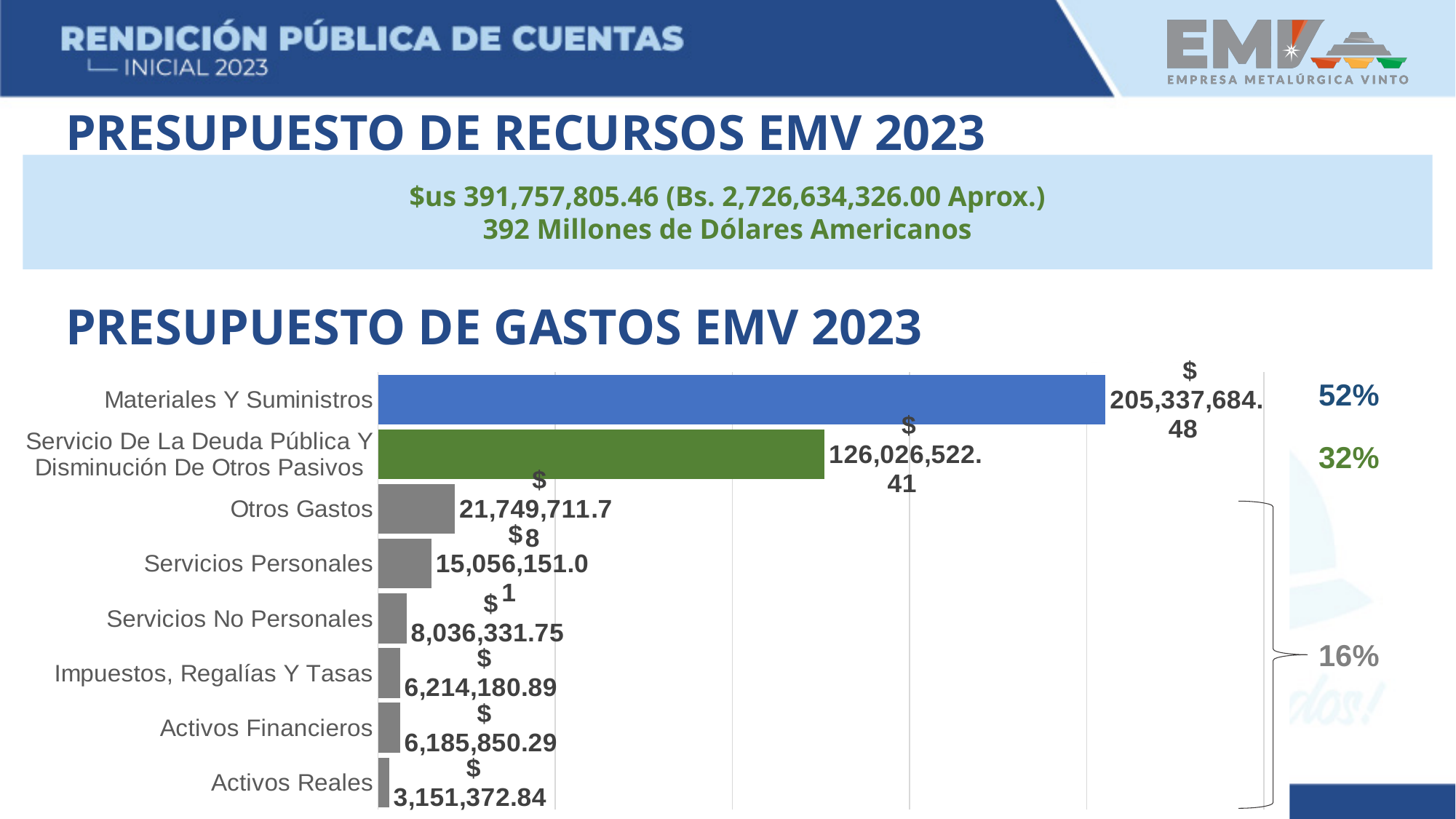
Which category has the lowest value in the PRESUPUESTO DE GASTOS EMV 2023 chart? Activos Reales Which is larger, Impuestos, Regalías Y Tasas or Activos Financieros? Impuestos, Regalías Y Tasas What is the value for Activos Reales in the expenses chart? $3,151,372.84 How many expense categories are plotted in the PRESUPUESTO DE GASTOS EMV 2023 chart? 8 What type of chart is shown under PRESUPUESTO DE GASTOS EMV 2023? Bar chart What is the difference between Materiales Y Suministros and Servicio De La Deuda Pública Y Disminución De Otros Pasivos? $79,311,162.07 Which category has the highest value in the PRESUPUESTO DE GASTOS EMV 2023 chart? Materiales Y Suministros What is the value for Servicios No Personales in the expenses chart? $8,036,331.75 What percentage is shown next to the Materiales Y Suministros bar? 52% What is the value for Materiales Y Suministros in the PRESUPUESTO DE GASTOS EMV 2023 chart? $205,337,684.48 What colour is the bar for Servicio De La Deuda Pública Y Disminución De Otros Pasivos? Green What is the value for Servicio De La Deuda Pública Y Disminución De Otros Pasivos? $126,026,522.41